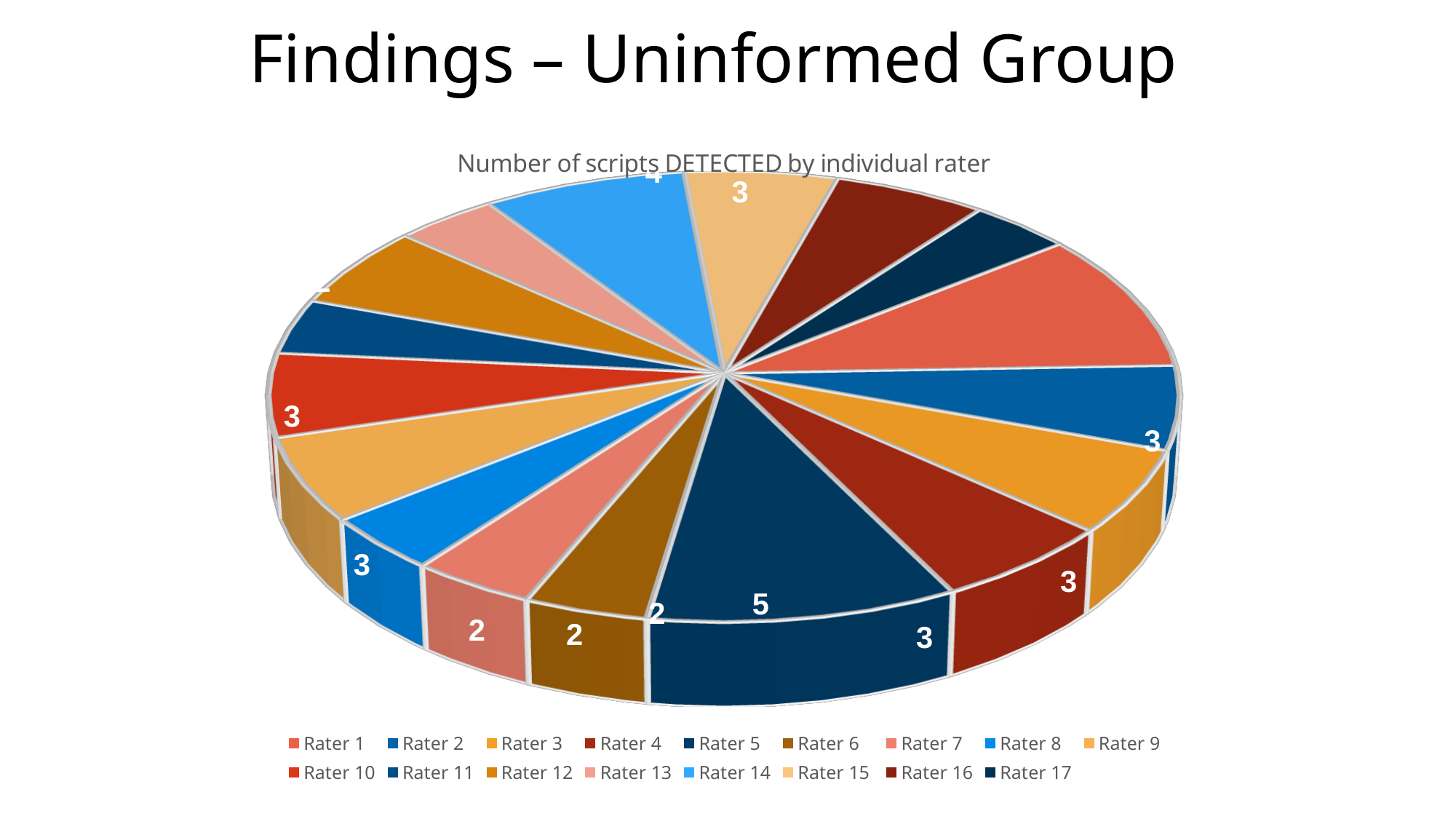
How many scripts were detected by Rater 15? 3 How many scripts were detected by Rater 7? 2 How many scripts were detected by Rater 2? 3 What kind of chart is shown on the slide? pie chart Which detected more scripts, Rater 5 or Rater 6? Rater 5 How many scripts were detected by Rater 4? 3 What is the title of the chart? Number of scripts DETECTED by individual rater How many scripts were detected by Rater 5? 5 How many scripts were detected by Rater 6? 2 How many scripts were detected by Rater 8? 2 What is the difference between the number of scripts detected by Rater 5 and by Rater 7? 3 How many raters are listed in the chart legend? 17